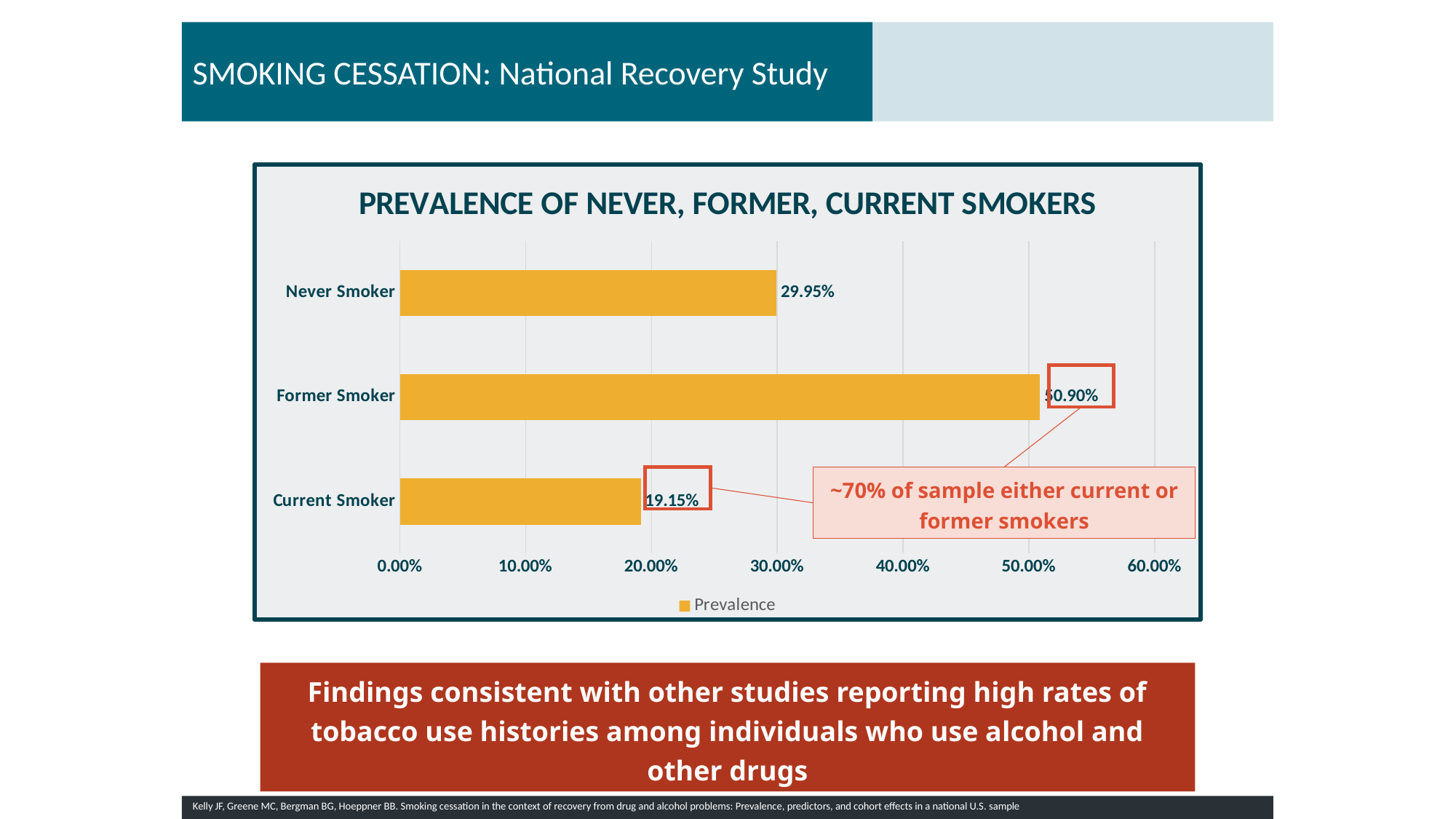
Which category has the lowest prevalence? Current Smoker What is the title of the chart? PREVALENCE OF NEVER, FORMER, CURRENT SMOKERS Is the value for Former Smoker greater or less than 50.00%? greater Which has a larger prevalence, Never Smoker or Current Smoker? Never Smoker How many categories are shown in the chart? 3 What is the prevalence value for Current Smoker? 19.15% What is the difference in prevalence between Former Smoker and Current Smoker? 31.75% Which category has the highest prevalence? Former Smoker What kind of chart is shown on the slide? Bar chart What is the difference in prevalence between Never Smoker and Current Smoker? 10.80% What is the prevalence value for Former Smoker? 50.90% What is the prevalence value for Never Smoker? 29.95%